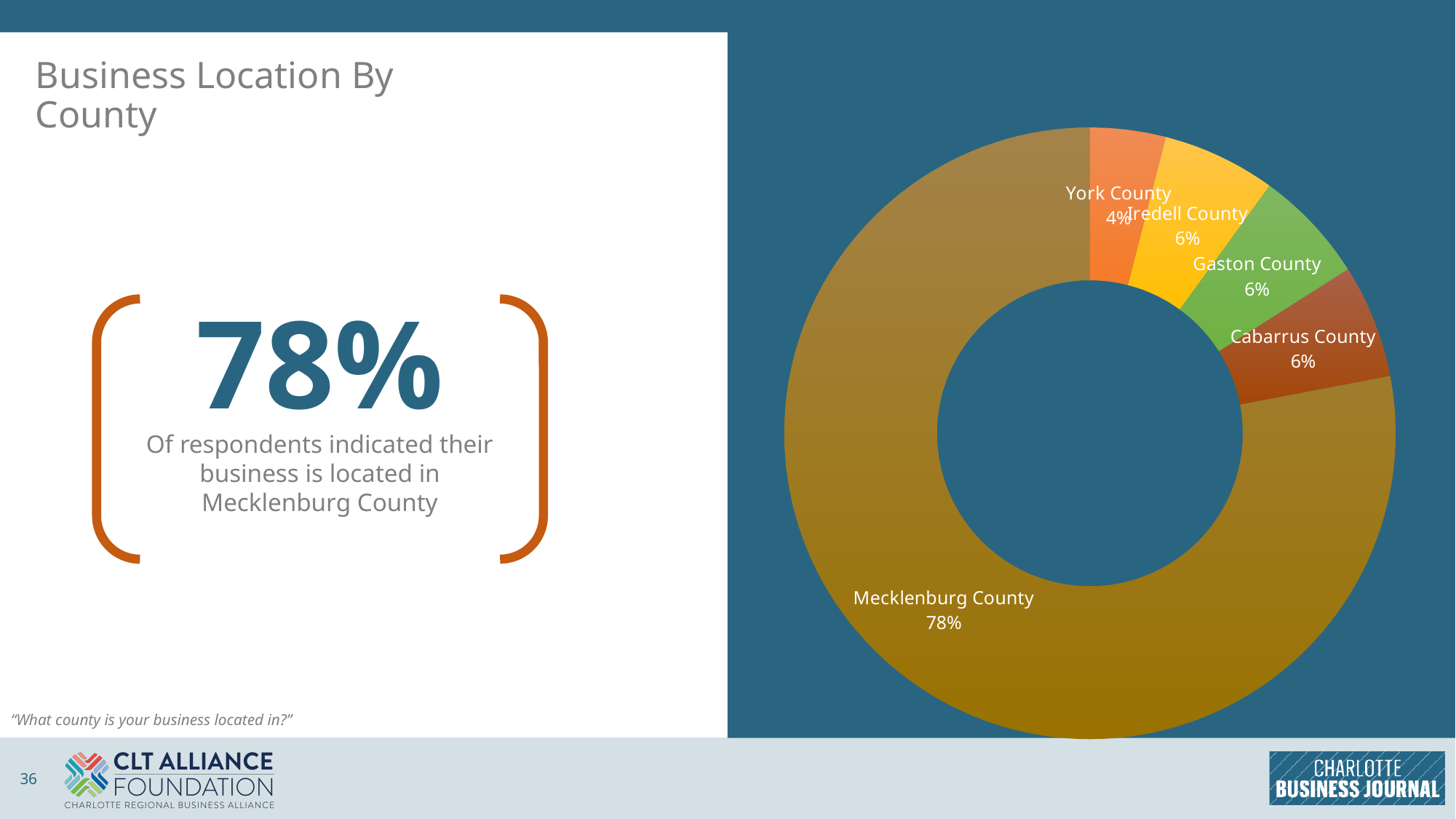
Which has a larger share, York County or Gaston County? Gaston County Which county has the largest share of respondents? Mecklenburg County What percentage of respondents are located in Gaston County? 6% Which county has the smallest share of respondents? York County How many counties are shown in the chart? 5 What percentage of respondents are located in Cabarrus County? 6% What percentage of respondents are located in York County? 4% What kind of chart is shown on the slide? Doughnut chart What survey question is quoted at the bottom of the slide? "What county is your business located in?" What is the difference in percentage points between Mecklenburg County and Iredell County? 72 What share of respondents are located in Mecklenburg County? 78% What is the title of the slide? Business Location By County